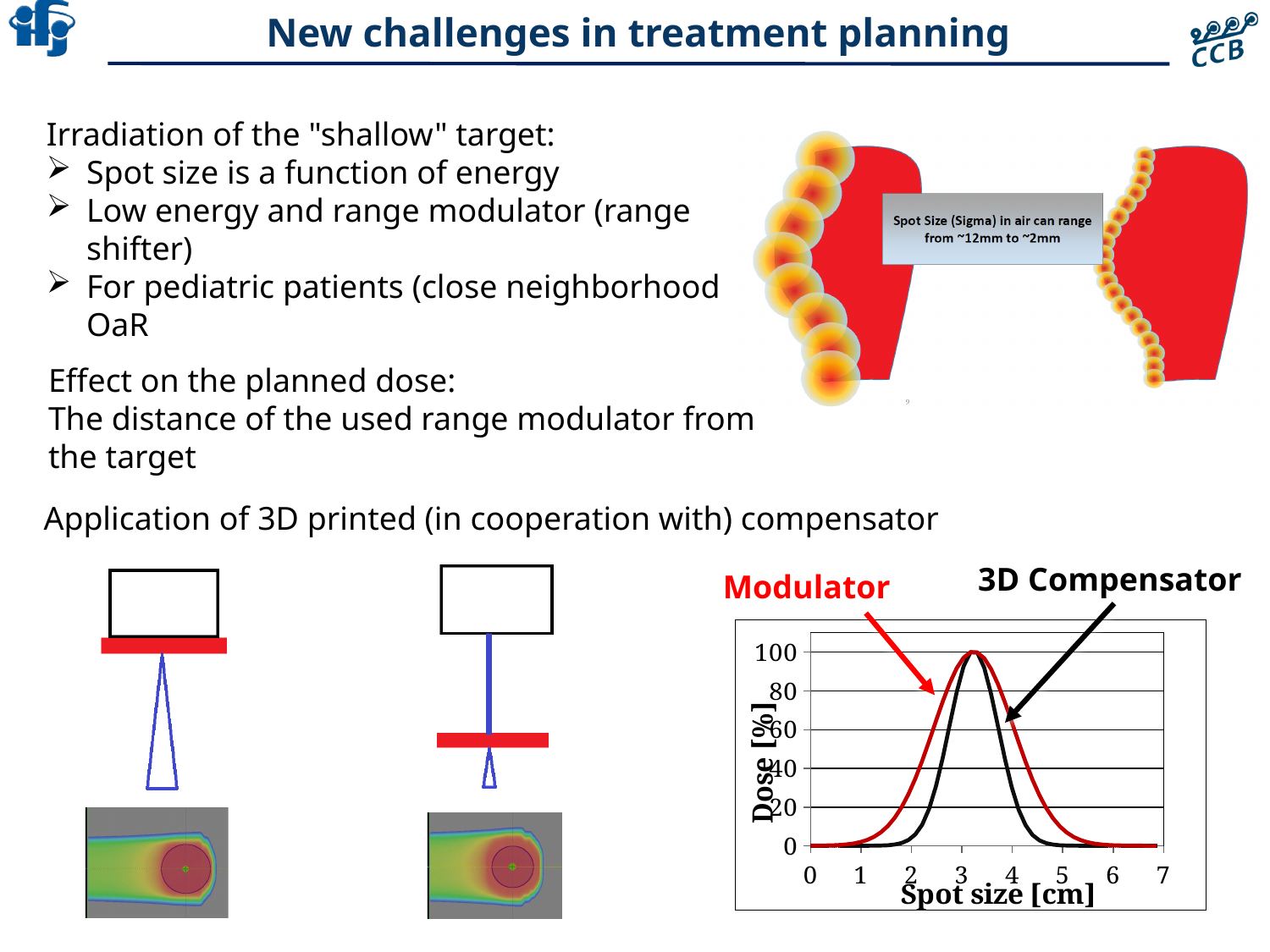
In the bottom-right chart, which curve is wider, the Modulator or the 3D Compensator? Modulator In the bottom-right chart, is the Modulator dose at a spot size of 1 cm greater or less than 20? less In the bottom-right chart, what is the highest value shown on the x axis? 7 In the bottom-right chart, which curve is drawn in red? Modulator In the bottom-right chart, do the dose values rise or fall as spot size increases from 4 cm to 7 cm? fall In the bottom-right chart, is the Modulator dose at a spot size of 3 cm greater or less than 60? greater In the bottom-right chart, how many curves are plotted? 2 In the bottom-right chart, what is the label of the x axis? Spot size [cm] In the bottom-right chart, is the 3D Compensator dose at a spot size of 5 cm greater or less than 20? less What kind of chart is shown at the bottom right of the slide? line chart In the bottom-right chart, what is the peak dose value reached by both curves? 100